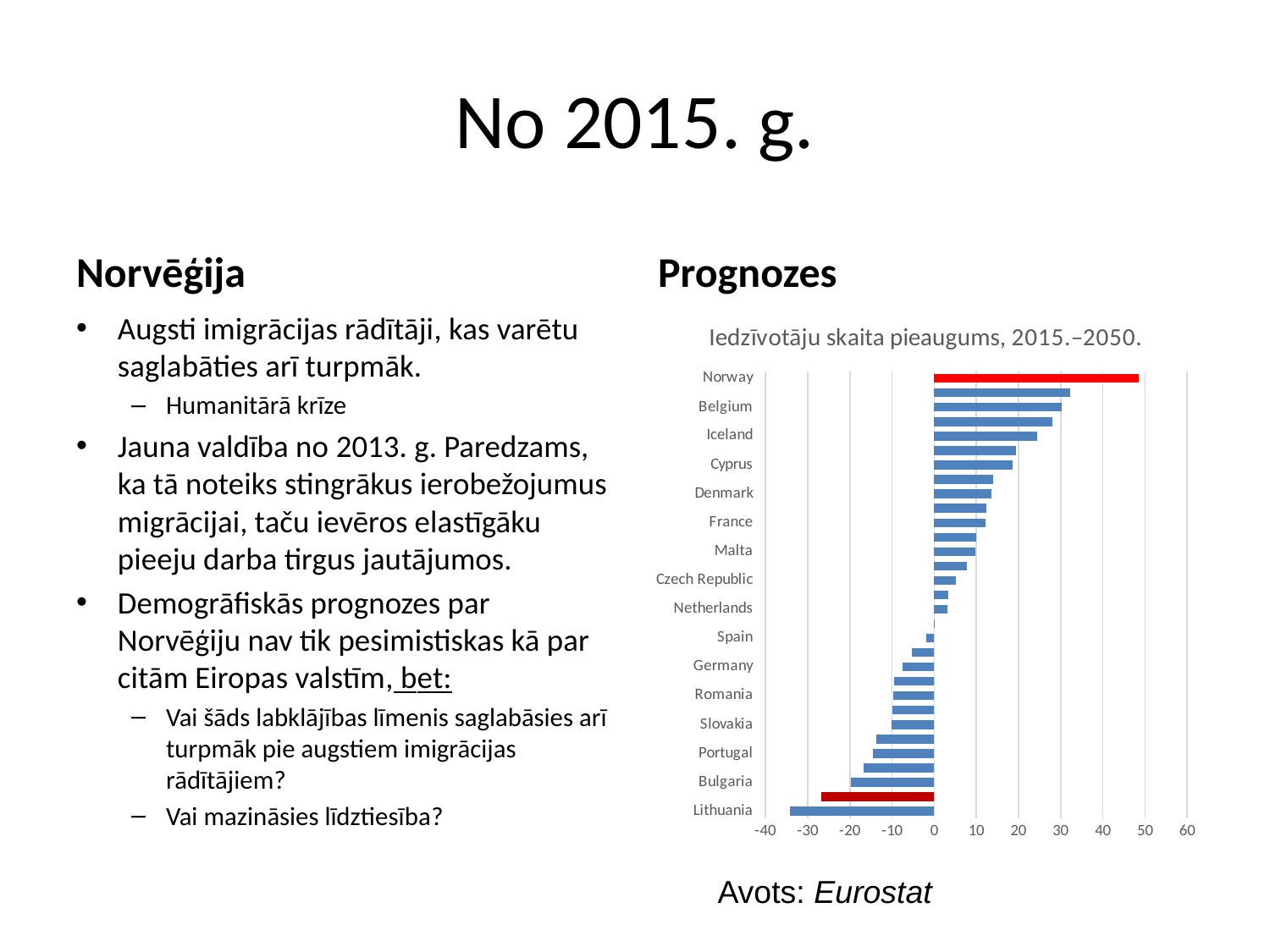
Which has the larger value, Norway or Belgium? Norway What colour is the bar for Norway? red Is the value for Germany greater or less than 0? less Which country has the highest value in the chart? Norway Is the value for Norway greater or less than 40? greater Which has the larger value, Denmark or Portugal? Denmark What is the title of the chart? Iedzīvotāju skaita pieaugums, 2015.–2050. Is the value for Belgium greater or less than 20? greater What kind of chart is shown on the slide? bar chart Which country has the lowest value in the chart? Lithuania